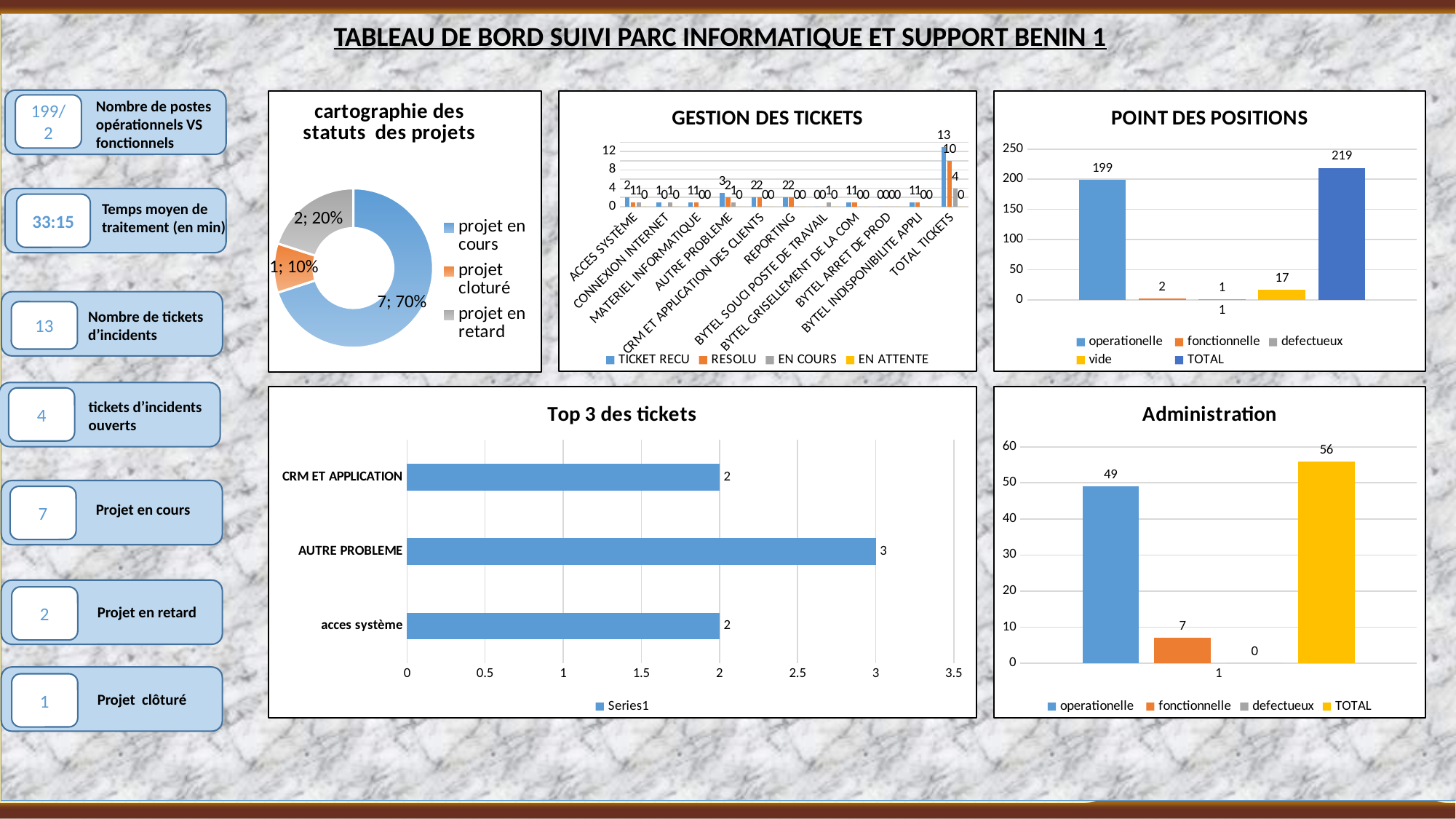
In the 'Administration' chart, which series has the lowest value? defectueux In the 'Administration' chart, what is the value for fonctionnelle? 7 What kind of chart is 'cartographie des statuts des projets'? Doughnut chart In the 'Administration' chart, is the value for operationelle greater or less than 40? greater In the 'POINT DES POSITIONS' chart, what is the difference between the TOTAL value and the operationelle value? 20 In the 'cartographie des statuts des projets' chart, what share does 'projet en cours' represent? 70% In the 'Top 3 des tickets' chart, how many categories are shown? 3 In the 'POINT DES POSITIONS' chart, what is the value for TOTAL? 219 In the 'POINT DES POSITIONS' chart, what is the value for operationelle? 199 In the 'Top 3 des tickets' chart, which category has the highest value? AUTRE PROBLEME In the 'GESTION DES TICKETS' chart, what is the TICKET RECU value for TOTAL TICKETS? 13 How many series does the legend of the 'POINT DES POSITIONS' chart list? 5